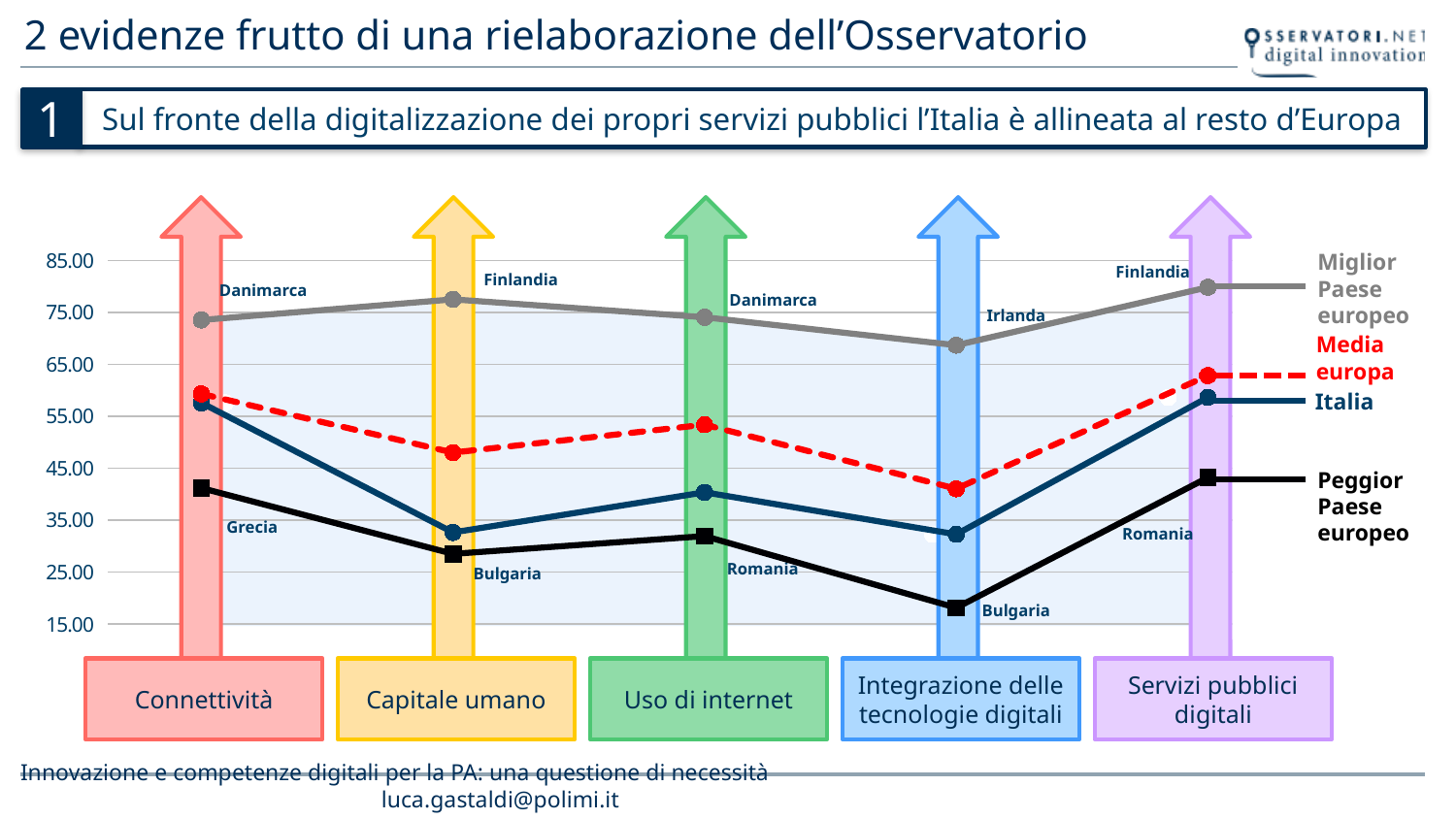
Is the value of Peggior Paese europeo for Integrazione delle tecnologie digitali greater or less than 25? less In which category does Peggior Paese europeo reach its lowest value? Integrazione delle tecnologie digitali Which country is labelled as the best European country for Connettività? Danimarca What kind of chart is shown on the slide? line chart Is the value of Italia for Uso di internet greater or less than 35? greater In which category does Miglior Paese europeo reach its highest value? Servizi pubblici digitali Is the value of Media europa for Integrazione delle tecnologie digitali greater or less than 45? less For Capitale umano, which is higher: Italia or Media europa? Media europa How many series does the chart show? 4 Does the Peggior Paese europeo line rise or fall from Uso di internet to Integrazione delle tecnologie digitali? fall How many categories are shown along the x axis of the chart? 5